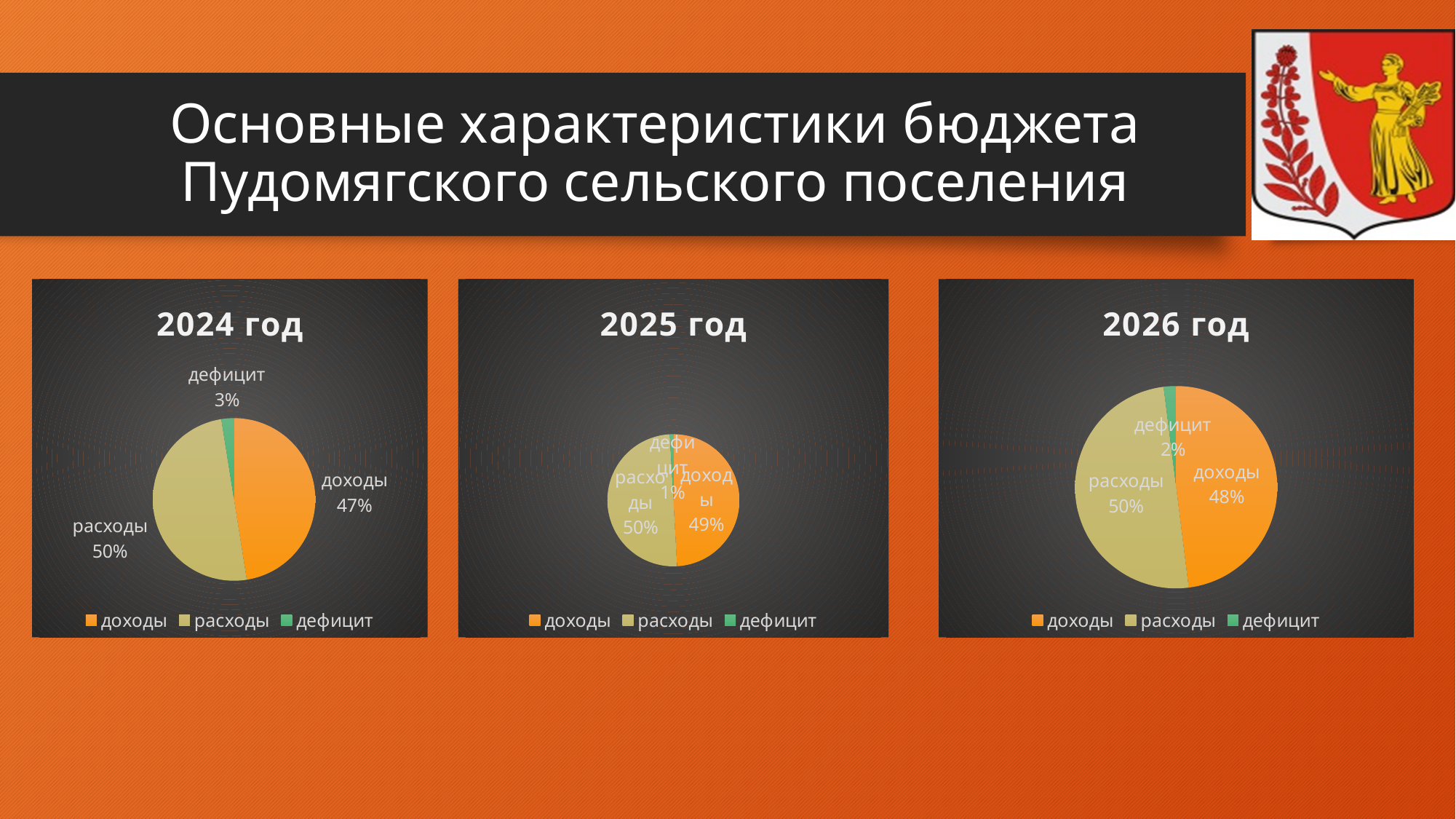
In the "2026 год" chart, what share does расходы have? 50% In the "2024 год" chart, what share does доходы have? 47% In the "2026 год" chart, which is larger, the share of доходы or the share of дефицит? доходы How many entries does the legend of the "2024 год" chart list? 3 In the "2024 год" chart, what share does дефицит have? 3% In the "2025 год" chart, which category has the largest slice? расходы How many slices does the "2025 год" chart have? 3 In the "2024 год" chart, which category has the smallest slice? дефицит In the "2026 год" chart, what share does доходы have? 48% What kind of chart is the "2026 год" chart? pie chart In the "2025 год" chart, what share does дефицит have? 1% In the "2024 год" chart, what is the difference between the shares of расходы and доходы? 3%